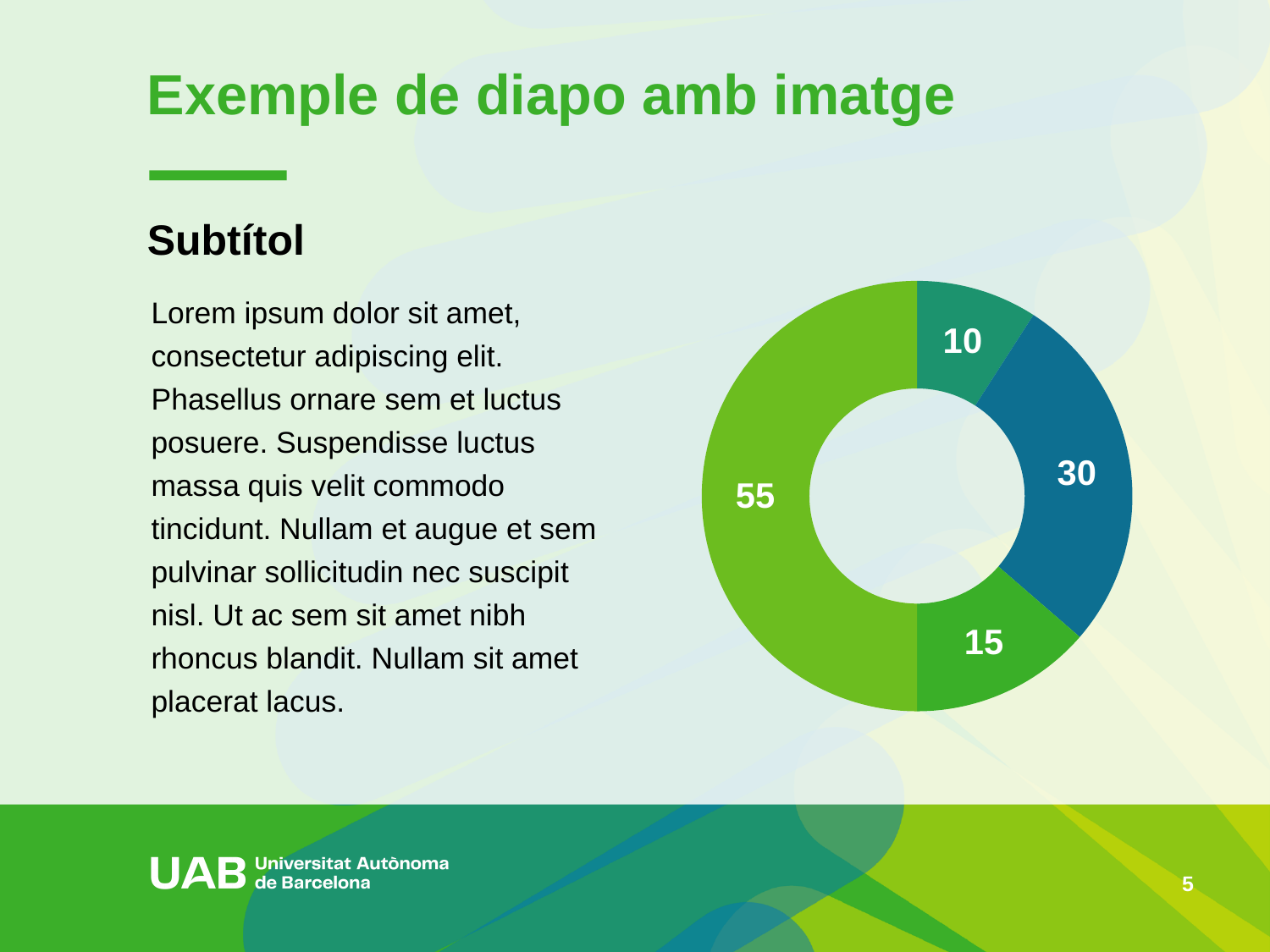
What is the total of all the values shown in the doughnut chart? 110 How many slices does the doughnut chart have? 4 Which is larger, the dark blue slice or the green slice labelled 15? The dark blue slice (30) What kind of chart is shown on the slide? Doughnut chart What is the smallest value shown in the doughnut chart? 10 What value is shown on the teal slice at the top of the doughnut chart? 10 What value is shown on the light green slice of the doughnut chart? 55 What is the difference between the slice labelled 15 and the slice labelled 10? 5 What share of the doughnut chart does the slice labelled 55 represent? 50% What is the difference between the largest slice (55) and the dark blue slice (30)? 25 What value is shown on the dark blue slice of the doughnut chart? 30 What is the largest value shown in the doughnut chart? 55